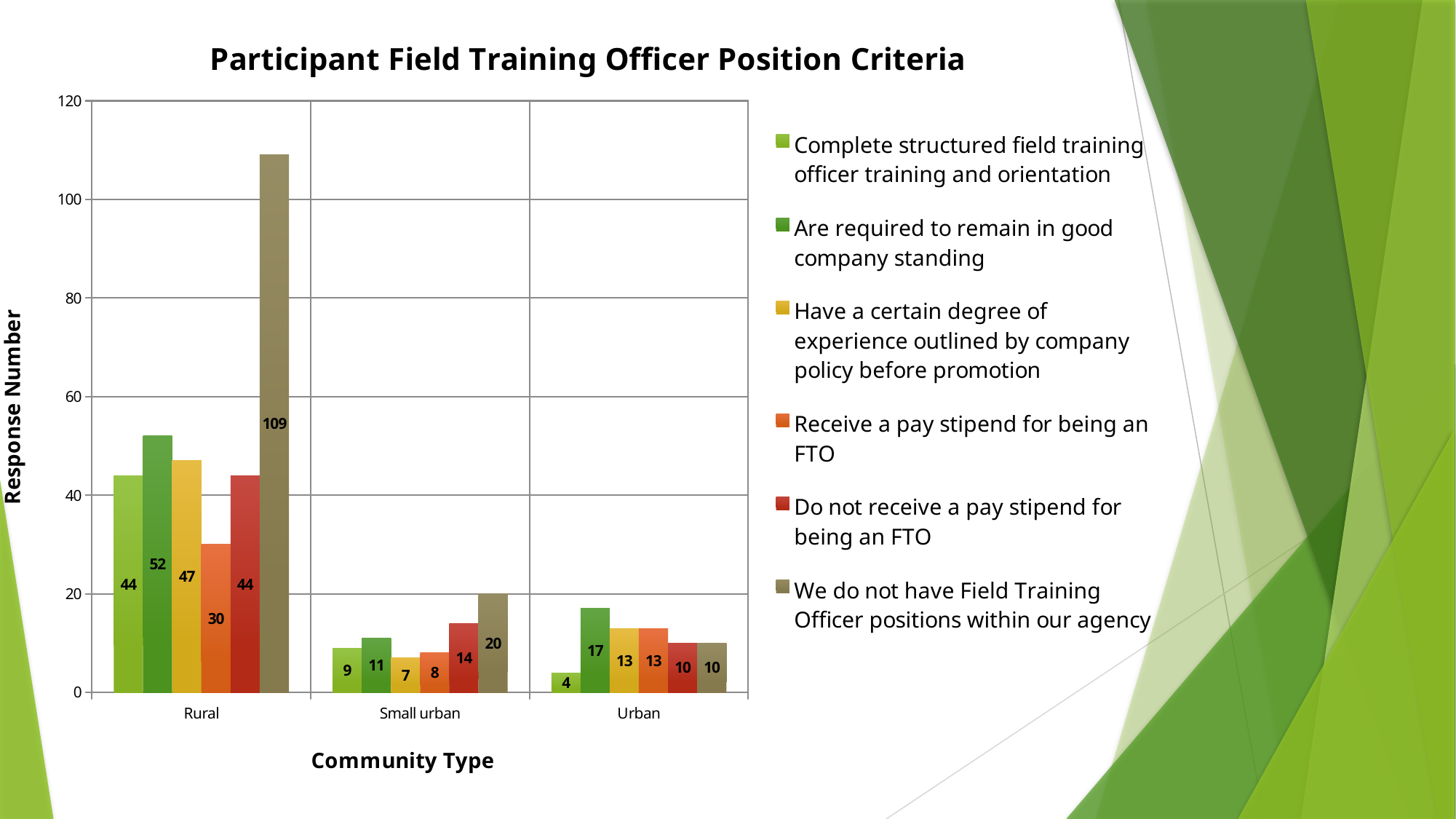
Which criterion has the lowest value in the Small urban community type? Have a certain degree of experience outlined by company policy before promotion What is the difference between the Rural values for 'Are required to remain in good company standing' and 'Receive a pay stipend for being an FTO'? 22 What kind of chart is shown on the slide? Bar chart What is the value for 'Complete structured field training officer training and orientation' in the Urban community type? 4 Which is larger in the Urban community type: 'Are required to remain in good company standing' or 'Have a certain degree of experience outlined by company policy before promotion'? Are required to remain in good company standing How many series does the legend list? 6 What is the title of the chart? Participant Field Training Officer Position Criteria What is the value for 'We do not have Field Training Officer positions within our agency' in the Rural community type? 109 What is the value for 'Do not receive a pay stipend for being an FTO' in the Small urban community type? 14 Which community type has the highest value for 'Are required to remain in good company standing'? Rural How many community types are shown on the x axis? 3 Is the Rural value for 'We do not have Field Training Officer positions within our agency' greater or less than 100? greater